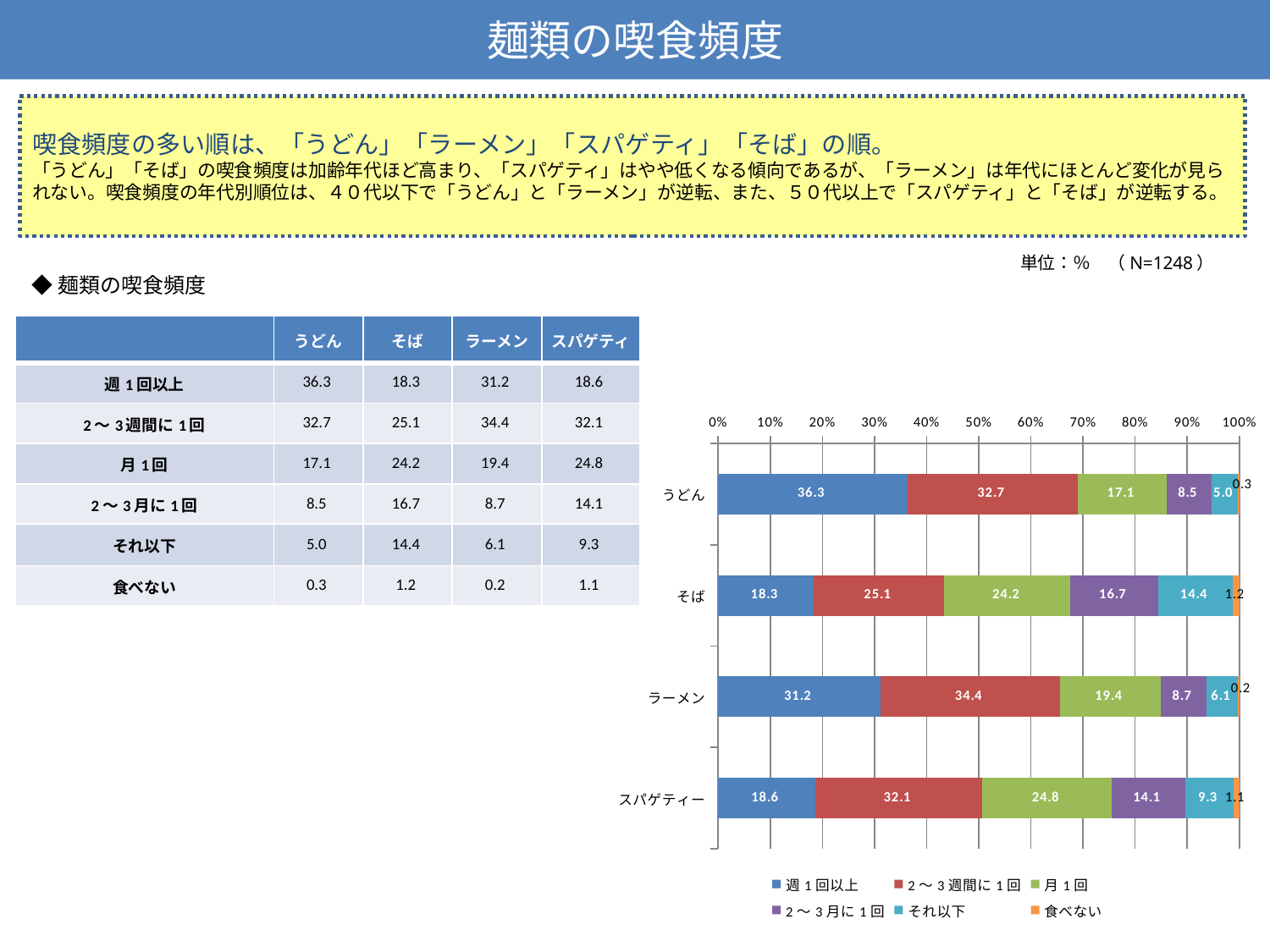
Which is larger, the 2〜3月に1回 value for そば or for ラーメン? そば What is the difference between the 週1回以上 values for うどん and そば? 18.0 Which noodle type has the highest value for 2〜3週間に1回? ラーメン What is the value for 食べない for ラーメン? 0.2 What is the value for それ以下 for そば? 14.4 Which noodle type has the lowest value for 2〜3月に1回? うどん What is the total of the stacked bar for ラーメン? 100.0 How many noodle types are shown on the chart? 4 What is the value for 週1回以上 for うどん? 36.3 What kind of chart is shown on the slide? Stacked bar chart How many series does the legend list? 6 Which noodle type has the highest value for 週1回以上? うどん